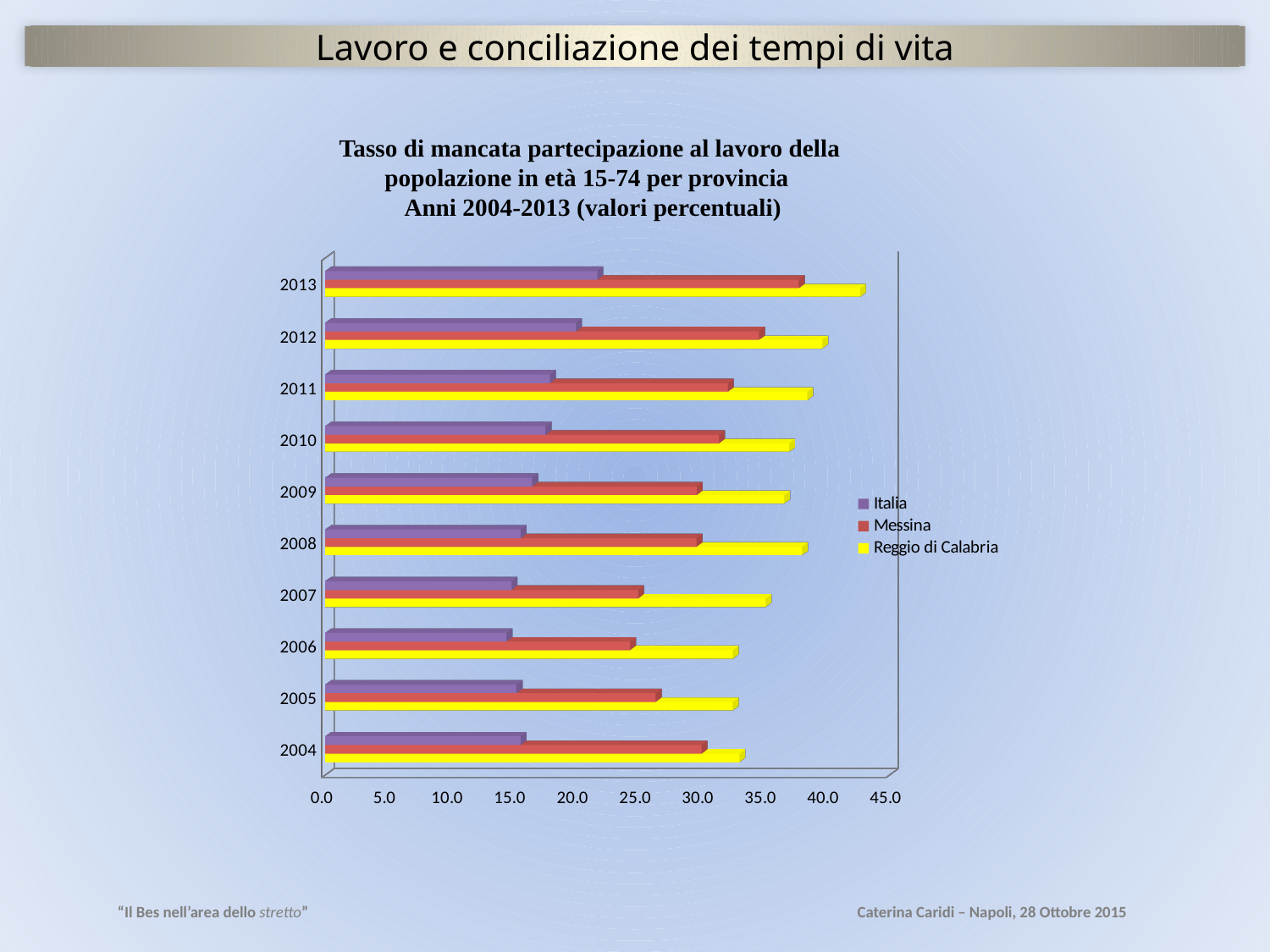
In which year is the value for Reggio di Calabria highest? 2013 What is the title of the chart? Tasso di mancata partecipazione al lavoro della popolazione in età 15-74 per provincia Anni 2004-2013 (valori percentuali) In which year is the value for Italia highest? 2013 From 2009 to 2013, do the values for Italia rise or fall? rise Which is larger in 2013, the value for Messina or the value for Italia? Messina How many series does the legend list? 3 How many years (categories) are shown on the chart? 10 Which series is shown in yellow in the legend? Reggio di Calabria In which year is the value for Messina highest? 2013 What kind of chart is shown on the slide? bar chart Is the value for Italia in 2006 greater or less than 20.0? less Is the value for Reggio di Calabria in 2013 greater or less than 40.0? greater